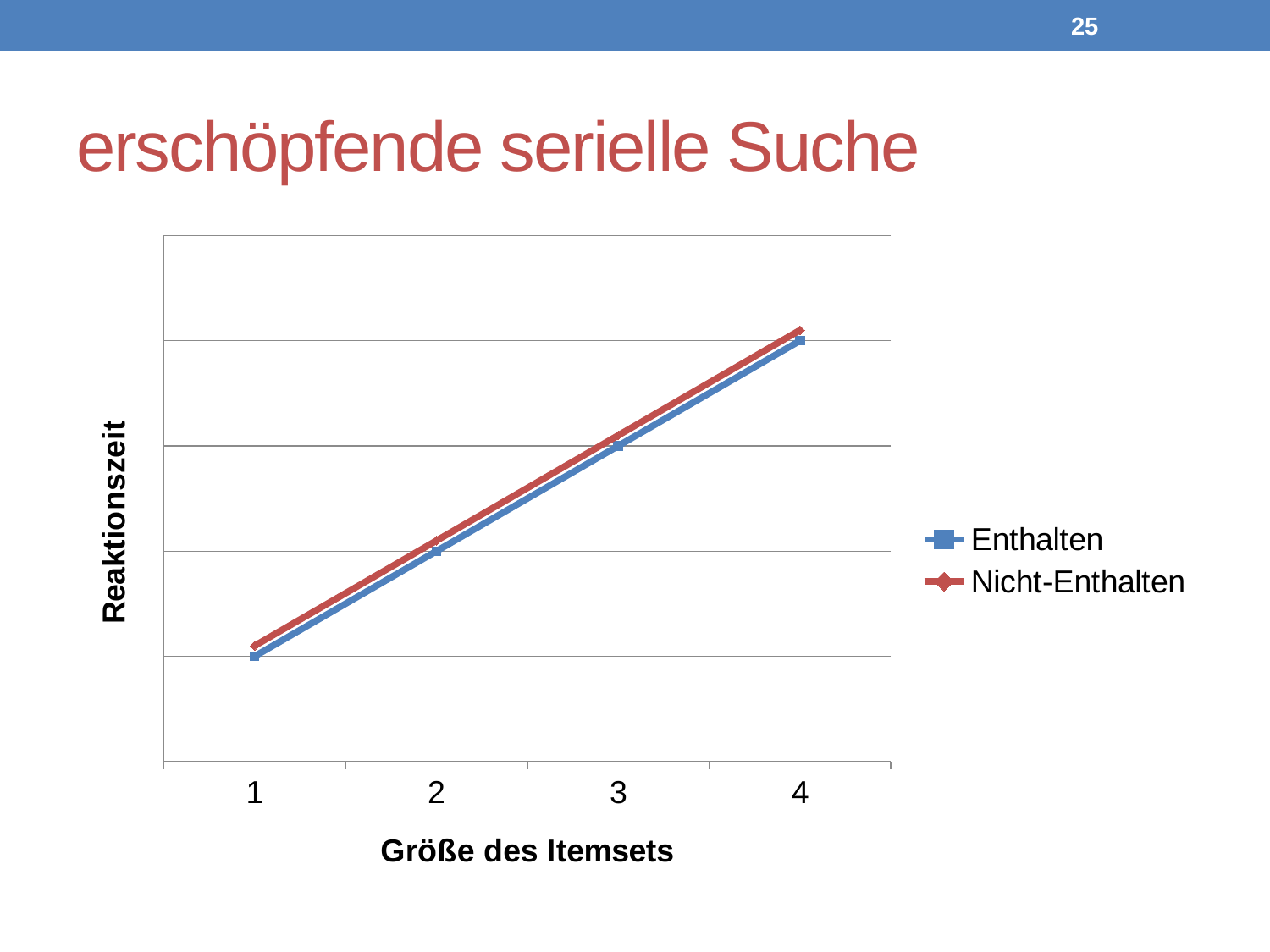
What is the title of the x axis? Größe des Itemsets Do the values for Nicht-Enthalten rise or fall as Größe des Itemsets increases from 1 to 4? rise Which is larger for Enthalten: the value at Größe des Itemsets 2 or at 3? 3 Which is larger for Nicht-Enthalten: the value at Größe des Itemsets 4 or at 1? 4 How many series does the legend list? 2 At which Größe des Itemsets is the Reaktionszeit for Enthalten highest? 4 What kind of chart is shown on the slide? line chart At which Größe des Itemsets is the Reaktionszeit for Nicht-Enthalten lowest? 1 What is the title of the y axis? Reaktionszeit Do the values for Enthalten rise or fall as Größe des Itemsets increases from 1 to 4? rise How many points are plotted along the x axis for each series? 4